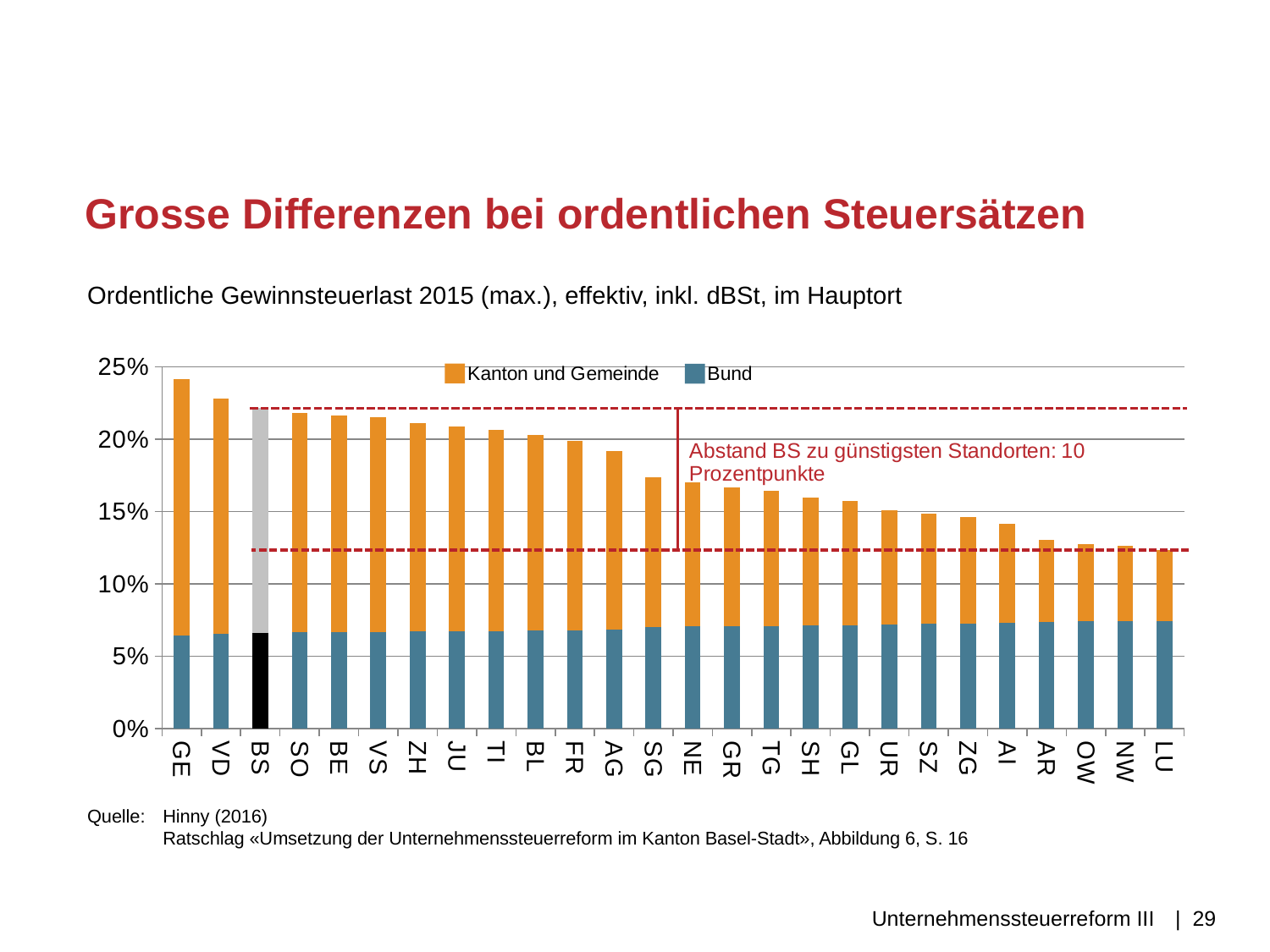
Is the total value for LU greater or less than 15%? less Which canton has the larger total tax burden, VD or SO? VD How many series does the chart legend list? 2 What kind of chart is shown on the slide? Stacked bar chart Which canton has the highest total tax burden in the chart? GE Is the total value for GE greater or less than 20%? greater What are the two legend entries of the chart? Kanton und Gemeinde; Bund Is the total value for AG greater or less than 20%? less Do the total bar heights rise or fall from left to right along the x axis? Fall How many cantons are shown along the x axis of the chart? 26 Which canton has the lowest total tax burden in the chart? LU